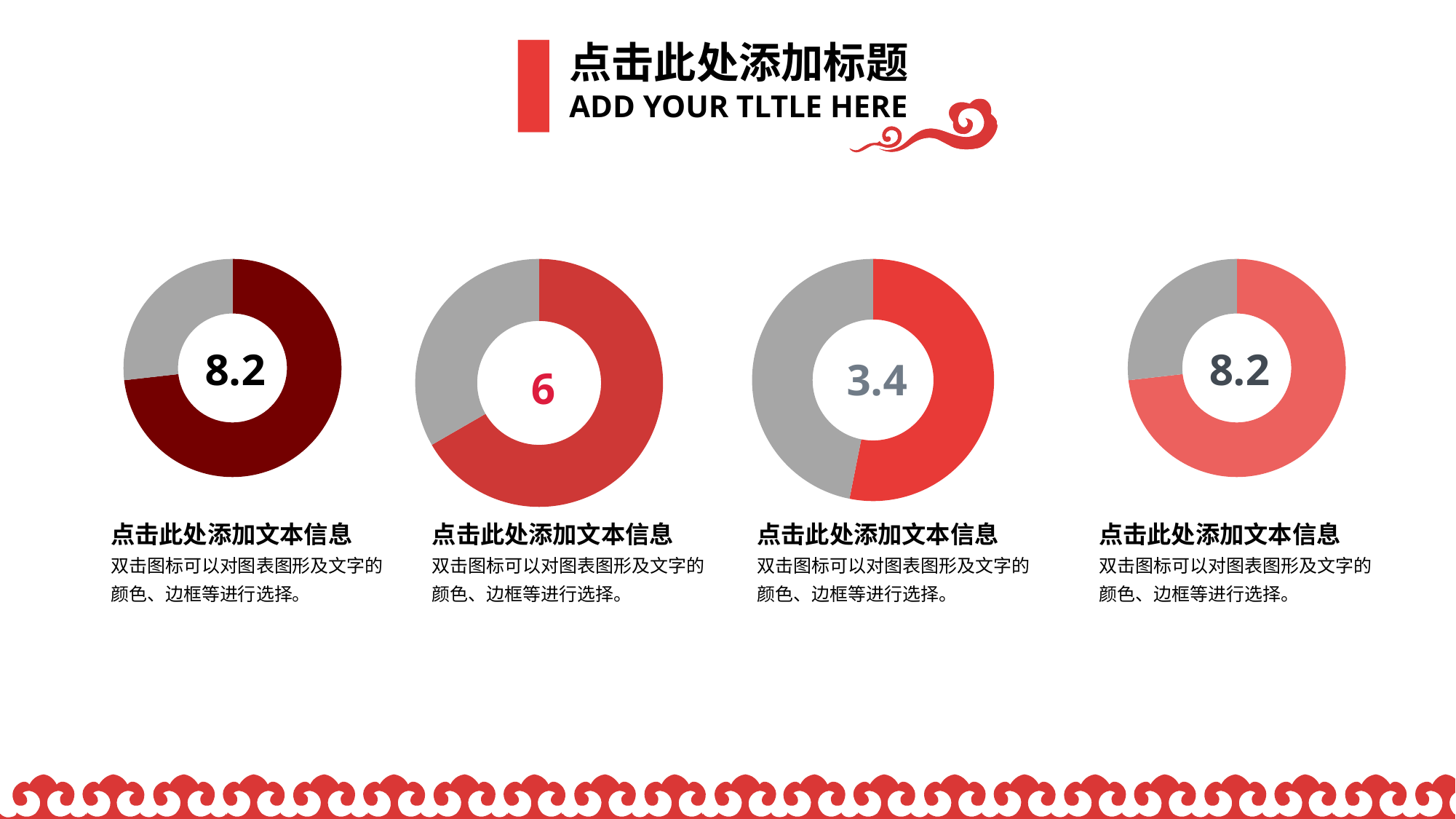
What is the difference between the centre values of the leftmost and second donut charts? 2.2 What kind of chart is used for each of the four charts on the slide? Donut (pie) chart What is the difference between the centre values of the second and third donut charts? 2.6 Which donut chart has the lowest centre value? The third from the left (3.4) What colour is the larger slice of the leftmost donut chart? Dark red Which is larger, the centre value of the leftmost donut chart or the third donut chart? The leftmost (8.2) How many donut charts are shown on the slide? 4 What value is printed in the centre of the leftmost donut chart? 8.2 What value is printed in the centre of the third donut chart from the left? 3.4 What value is printed in the centre of the second donut chart from the left? 6 What value is printed in the centre of the rightmost donut chart? 8.2 What colour is the smaller slice in each of the four donut charts? Grey